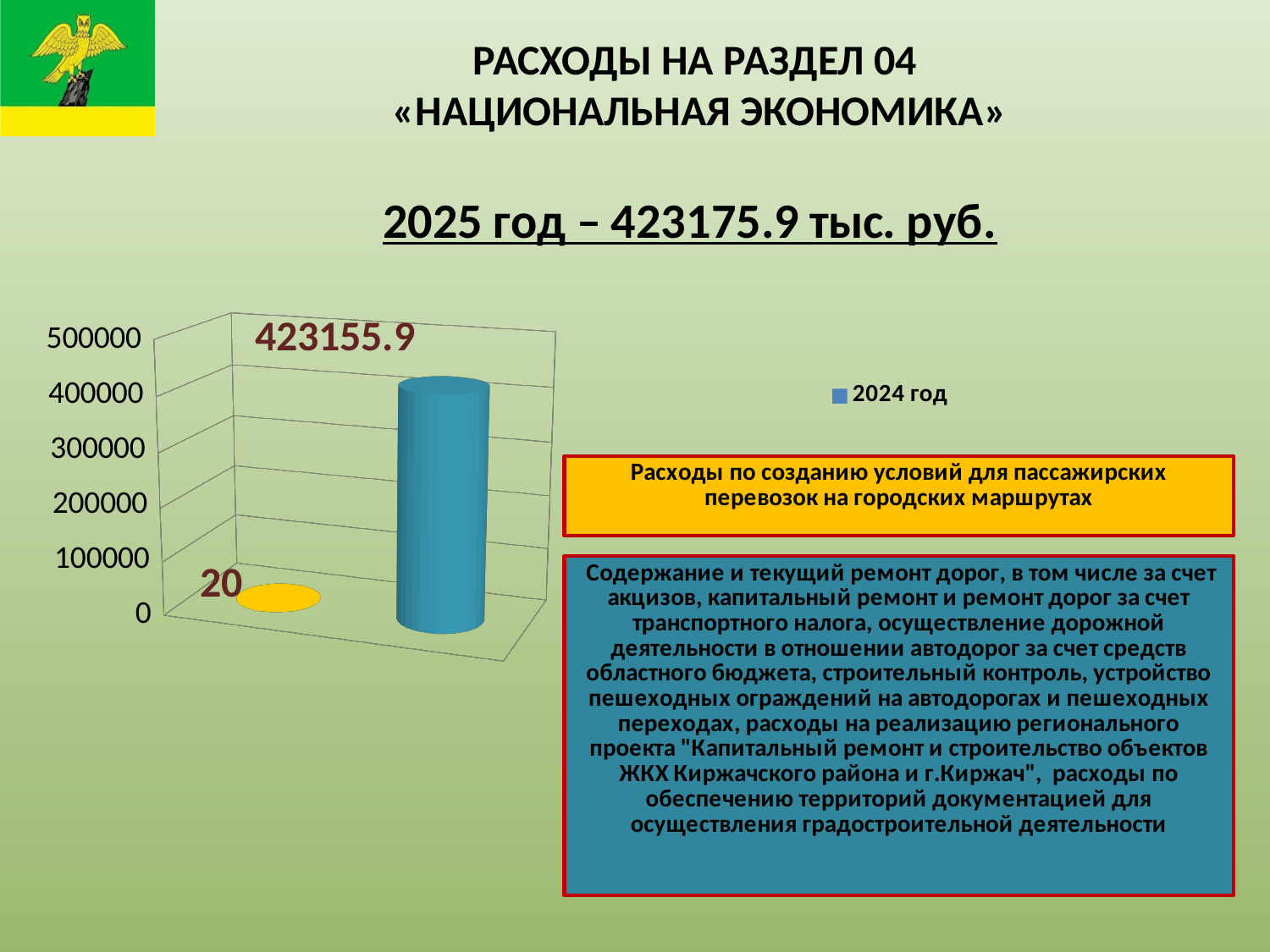
What is the legend entry shown next to the chart? 2024 год How many bars are plotted in the chart? 2 Is the value of the blue bar greater or less than 400000? greater What value is labelled on the yellow bar in the chart? 20 What value is labelled on the blue bar in the chart? 423155.9 What is the difference between the blue bar's value and the yellow bar's value? 423135.9 Which bar in the chart has the lowest value, the yellow one or the blue one? the yellow bar What type of chart is shown on the slide? bar chart What is the highest value shown on the vertical axis of the chart? 500000 Which bar in the chart has the highest value, the yellow one or the blue one? the blue bar How many entries does the chart legend list? 1 Is the value of the yellow bar greater or less than 100000? less